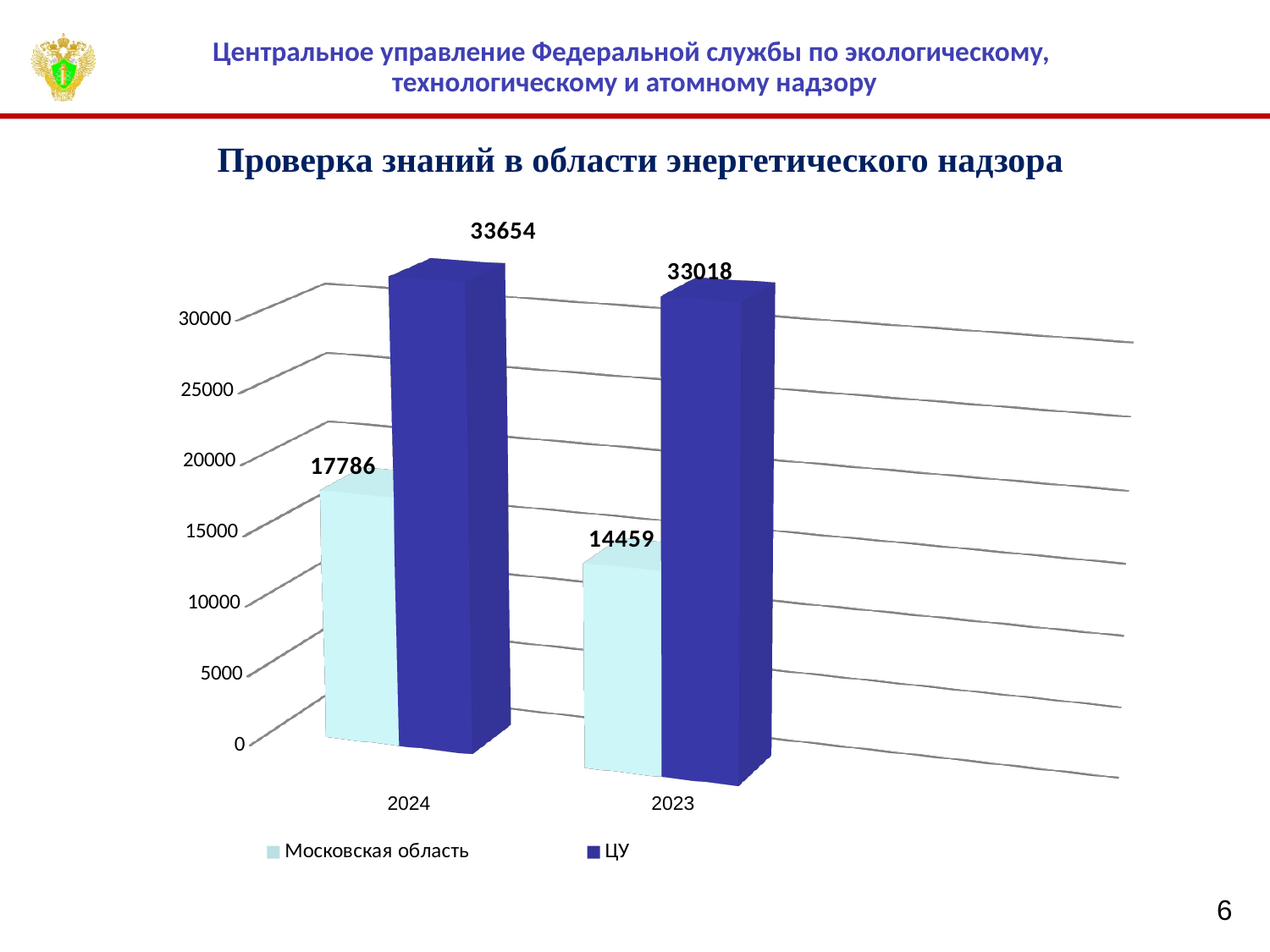
What is the value for Московская область in 2023? 14459 Which year has the lower value for ЦУ? 2023 What is the value for ЦУ in 2024? 33654 Which year has the higher value for Московская область? 2024 What is the title of the chart? Проверка знаний в области энергетического надзора What is the difference between the ЦУ value and the Московская область value in 2024? 15868 What kind of chart is shown on the slide? Bar chart How many series does the legend list? 2 What is the value for Московская область in 2024? 17786 What is the value for ЦУ in 2023? 33018 What is the difference between the Московская область values for 2024 and 2023? 3327 Which is larger in 2023: the value for ЦУ or for Московская область? ЦУ